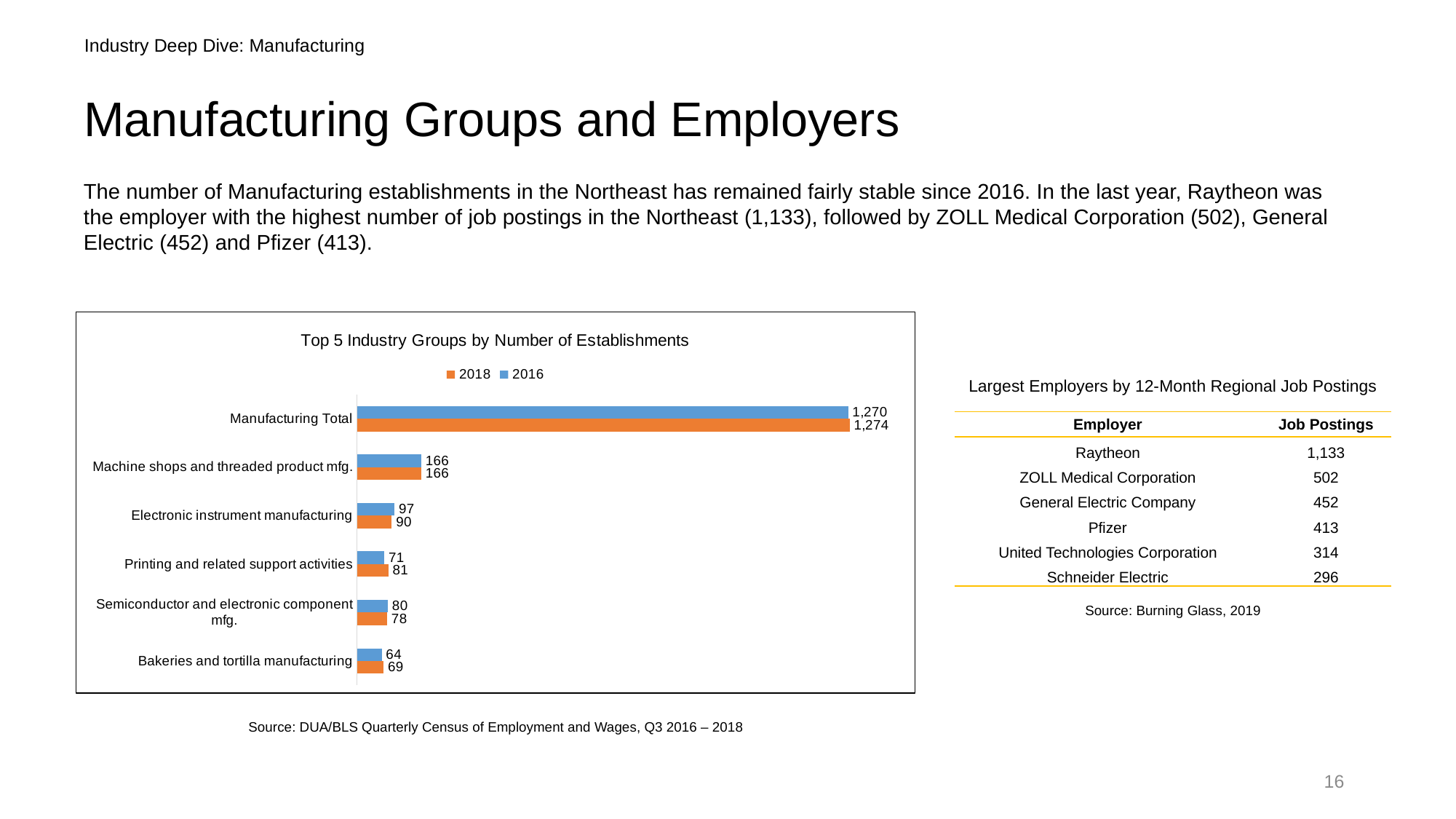
What is the 2016 value for Bakeries and tortilla manufacturing in the 'Top 5 Industry Groups by Number of Establishments' chart? 64 How many series does the legend of the 'Top 5 Industry Groups by Number of Establishments' chart list? 2 What is the 2018 value for Printing and related support activities in the 'Top 5 Industry Groups by Number of Establishments' chart? 81 How many categories are shown on the 'Top 5 Industry Groups by Number of Establishments' chart? 6 Which colour represents the 2018 series in the 'Top 5 Industry Groups by Number of Establishments' chart? orange In the 'Top 5 Industry Groups by Number of Establishments' chart, what is the difference between the 2016 and 2018 values for Printing and related support activities? 10 Which category has the lowest 2016 value in the 'Top 5 Industry Groups by Number of Establishments' chart? Bakeries and tortilla manufacturing What kind of chart is 'Top 5 Industry Groups by Number of Establishments'? bar chart What is the 2018 value for Manufacturing Total in the 'Top 5 Industry Groups by Number of Establishments' chart? 1,274 Excluding Manufacturing Total, which industry group has the highest 2018 value in the 'Top 5 Industry Groups by Number of Establishments' chart? Machine shops and threaded product mfg. What is the 2016 value for Electronic instrument manufacturing in the 'Top 5 Industry Groups by Number of Establishments' chart? 97 In the 'Top 5 Industry Groups by Number of Establishments' chart, is the 2016 value for Electronic instrument manufacturing larger or smaller than its 2018 value? larger